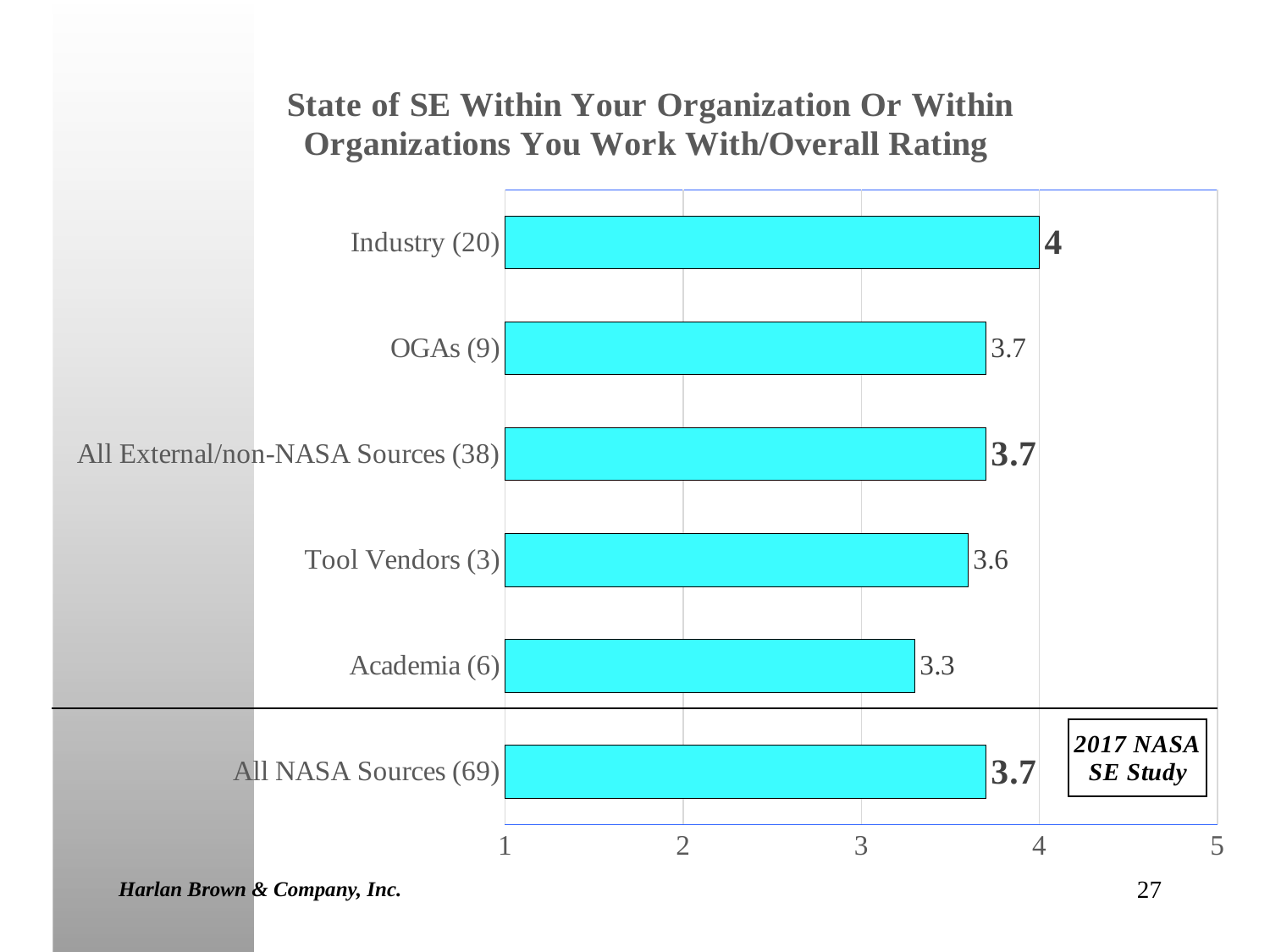
Is the value for Academia (6) greater or less than 3? greater What is the difference between the ratings for Industry (20) and Academia (6)? 0.7 How many categories are shown in the chart? 6 What is the title of the chart? State of SE Within Your Organization Or Within Organizations You Work With/Overall Rating Which category has the highest overall rating? Industry (20) What kind of chart is shown on the slide? Bar chart Which category has the lowest overall rating? Academia (6) What is the overall rating for Academia (6)? 3.3 What is the overall rating for All NASA Sources (69)? 3.7 What is the overall rating for Industry (20)? 4 Which has a higher rating, OGAs (9) or Tool Vendors (3)? OGAs (9) What is the overall rating for Tool Vendors (3)? 3.6